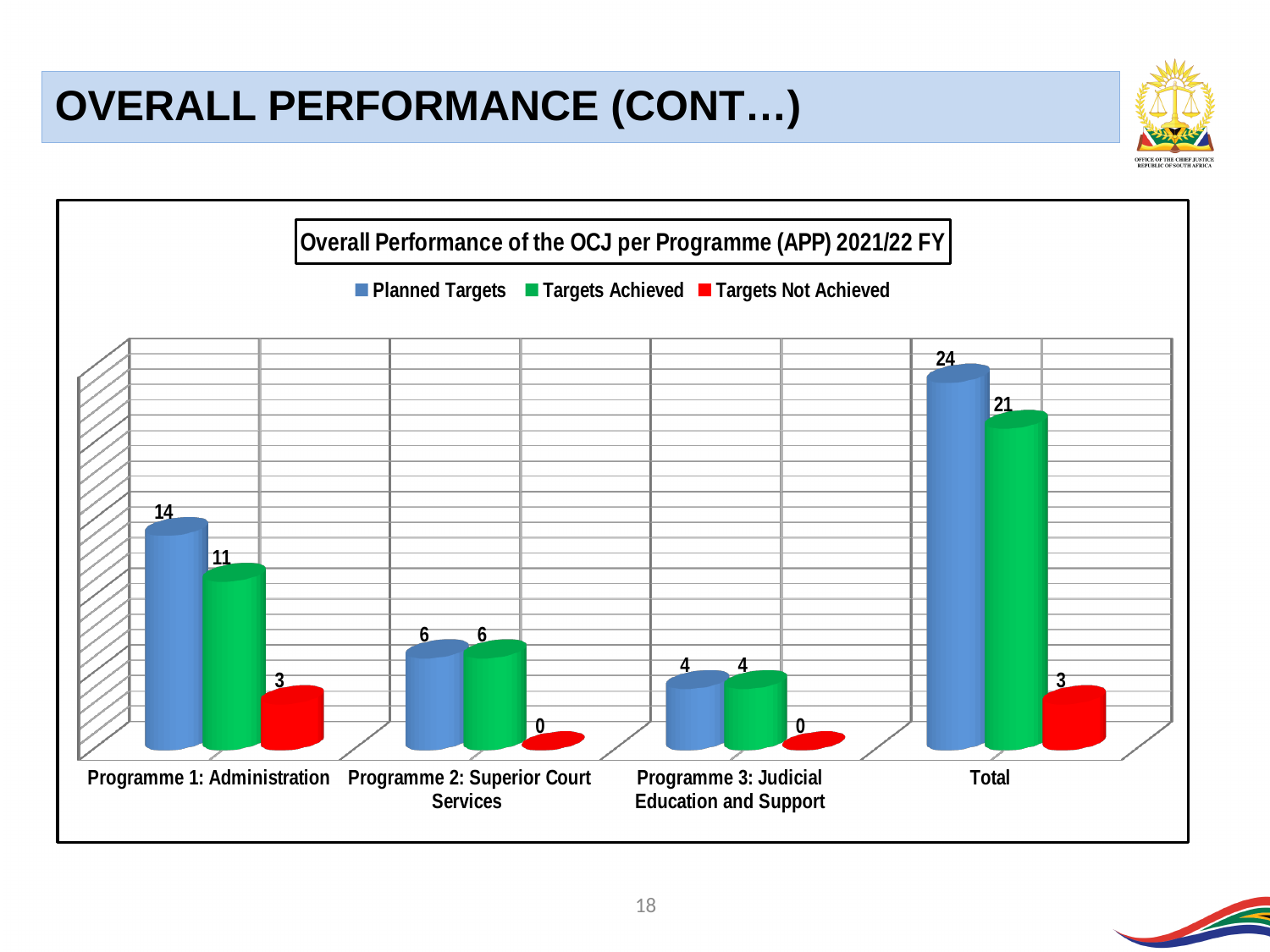
Which category has the highest Planned Targets value? Total What is the value of Targets Not Achieved for Programme 2: Superior Court Services? 0 How many categories are shown on the x axis? 4 What is the value of Targets Achieved for Programme 3: Judicial Education and Support? 4 What is the difference between Planned Targets and Targets Achieved for Programme 1: Administration? 3 What is the value of Targets Achieved for Total? 21 Which is larger for Programme 1: Administration, Planned Targets or Targets Not Achieved? Planned Targets What is the value of Planned Targets for Programme 1: Administration? 14 What is the title of the chart? Overall Performance of the OCJ per Programme (APP) 2021/22 FY Which programme has the lowest Planned Targets value? Programme 3: Judicial Education and Support What kind of chart is shown on the slide? Bar chart How many series does the legend list? 3